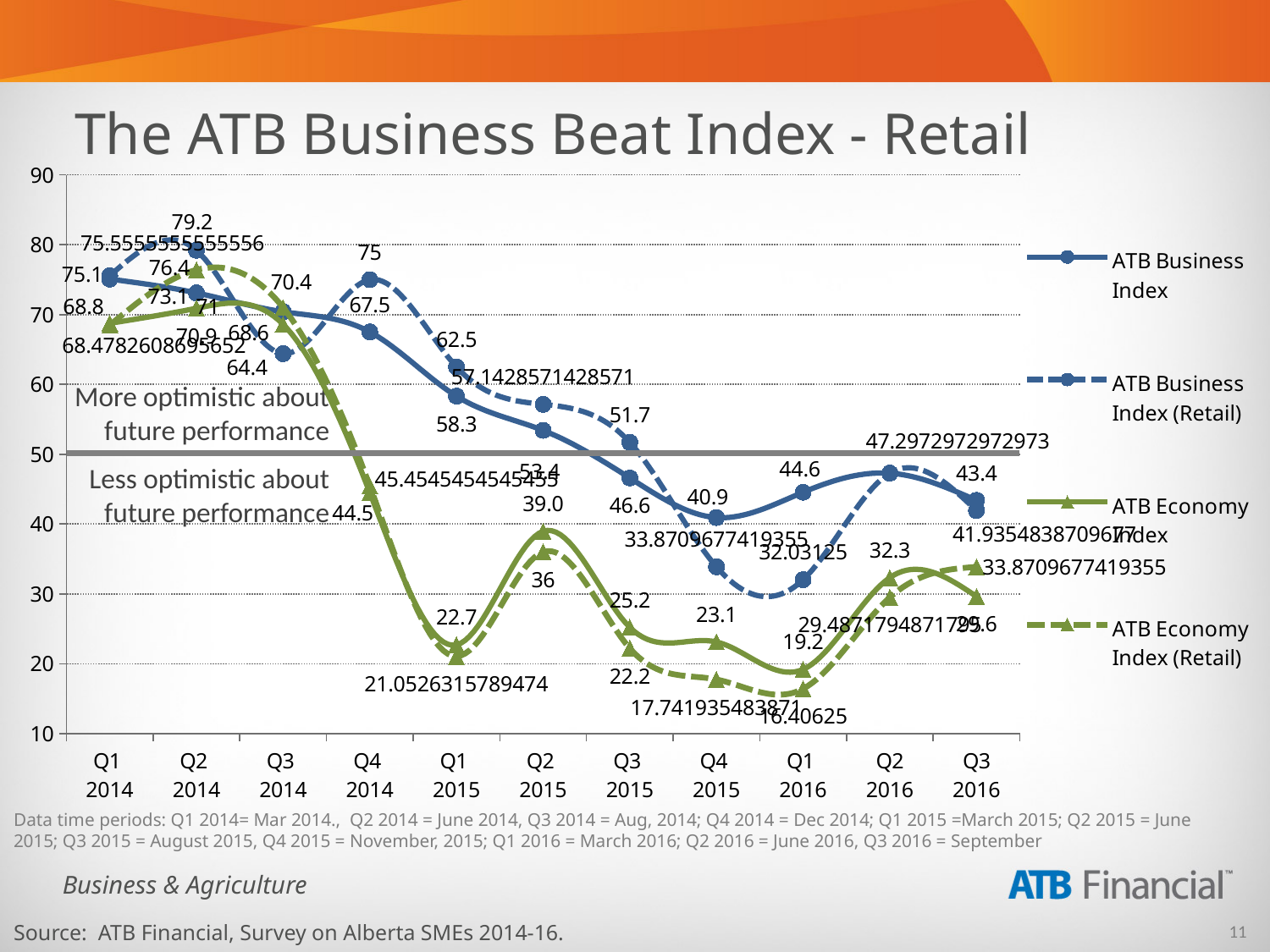
What is the value of the ATB Business Index in Q1 2015? 58.3 Is the value of the ATB Business Index (Retail) in Q2 2016 greater or less than 40? greater How many quarters are plotted along the x axis? 11 In Q2 2014, which is larger: the ATB Business Index or the ATB Business Index (Retail)? ATB Business Index (Retail) In which quarter does the ATB Business Index (Retail) reach its highest value? Q2 2014 What is the value of the ATB Economy Index in Q2 2016? 32.3 What type of chart is shown on the slide? Line chart How many series does the legend list? 4 What is the difference between the ATB Economy Index in Q2 2015 (39.0) and in Q3 2015 (25.2)? 13.8 What is the value of the ATB Economy Index in Q1 2016? 19.2 Which series has the lowest value on the chart, and in which quarter? ATB Economy Index (Retail), Q1 2016 What is the value of the ATB Business Index (Retail) in Q2 2014? 79.2